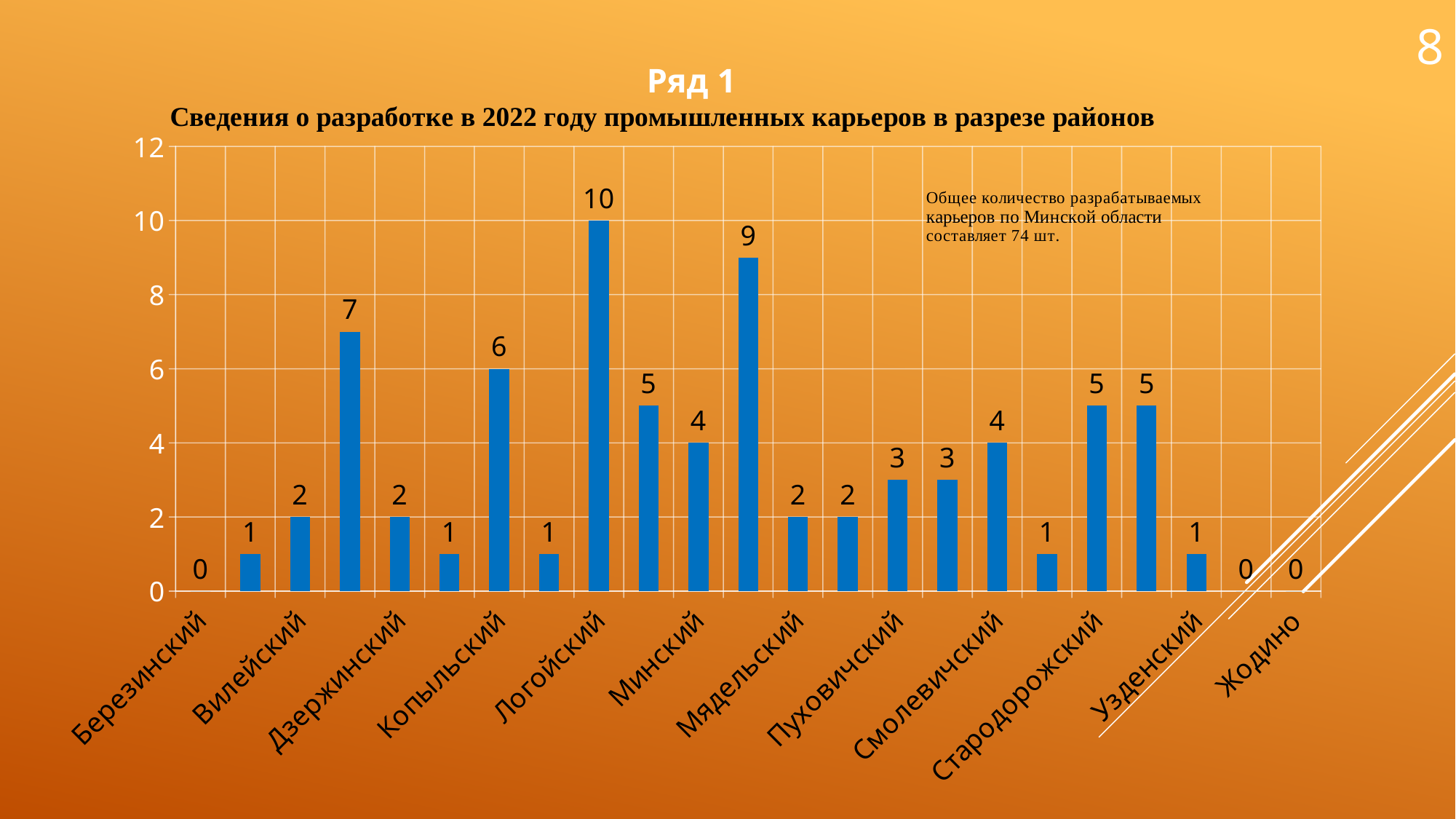
What is the value for Логойский? 10 What kind of chart is shown on the slide? bar chart What is the value for Жодино? 0 Which is larger, the value for Смолевичский or the value for Пуховичский? Смолевичский What is the difference between the values for Логойский and Стародорожский? 5 What is the value for Смолевичский? 4 What is the value for Пуховичский? 3 How many bars are plotted in the chart? 23 Which labelled category has the highest value? Логойский What is the value for Стародорожский? 5 Is the value for Логойский greater or less than 8? greater What is the title of the chart? Ряд 1